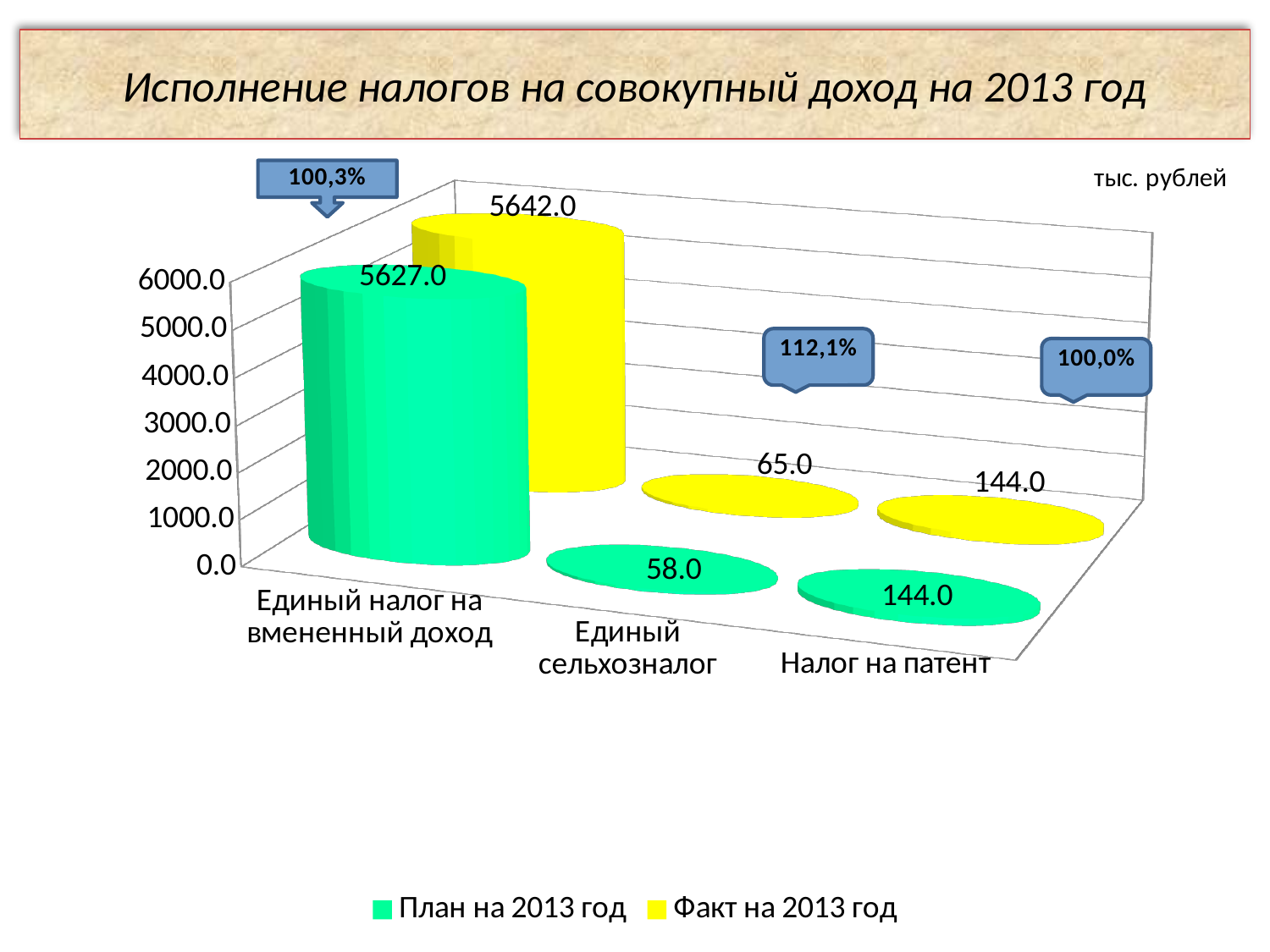
Which category has the lowest value for План на 2013 год? Единый сельхозналог What is the difference between Факт на 2013 год and План на 2013 год for Единый сельхозналог? 7.0 What is the value of План на 2013 год for Налог на патент? 144.0 What kind of chart is shown on the slide? Bar chart What is the value of Факт на 2013 год for Единый сельхозналог? 65.0 How many series does the legend list? 2 What is the value of Факт на 2013 год for Единый налог на вмененный доход? 5642.0 How many categories are shown on the x axis? 3 Which is larger for Единый налог на вмененный доход: План на 2013 год or Факт на 2013 год? Факт на 2013 год Which category has the highest value for Факт на 2013 год? Единый налог на вмененный доход What unit is indicated in the top right corner of the chart? тыс. рублей What is the value of План на 2013 год for Единый налог на вмененный доход? 5627.0